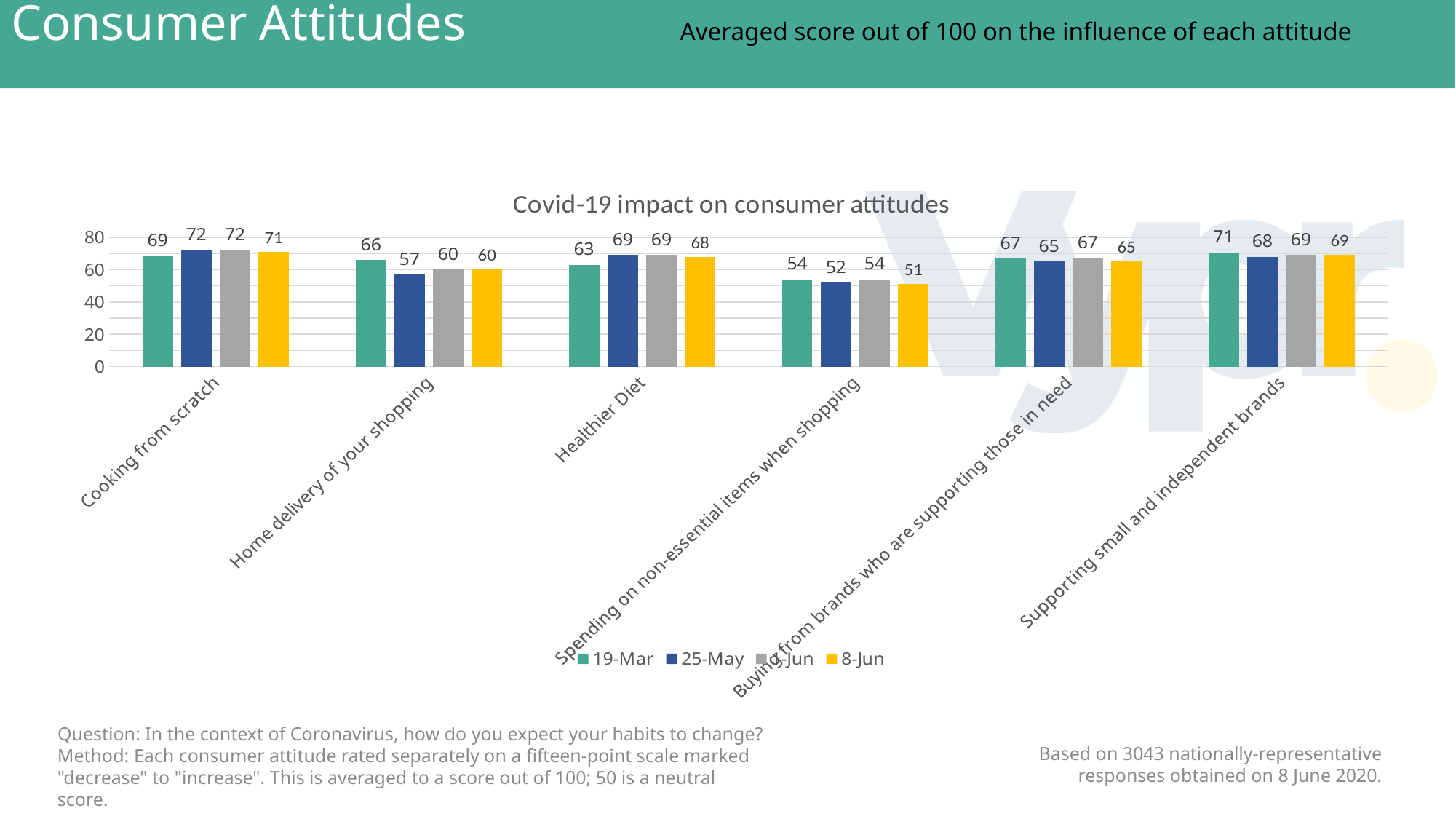
What is the 8-Jun value for Spending on non-essential items when shopping? 51 What is the 25-May value for Home delivery of your shopping? 57 What is the 19-Mar value for Cooking from scratch? 69 What kind of chart is shown on the slide? Bar chart How many series does the legend list? 4 How many categories are shown on the x axis? 6 Which category has the lowest 8-Jun value? Spending on non-essential items when shopping Which category has the highest 25-May value? Cooking from scratch What is the 19-Mar value for Supporting small and independent brands? 71 Which is larger for Healthier Diet: the 19-Mar value or the 25-May value? 25-May What is the title of the chart? Covid-19 impact on consumer attitudes What is the difference between the 19-Mar and 25-May values for Home delivery of your shopping? 9